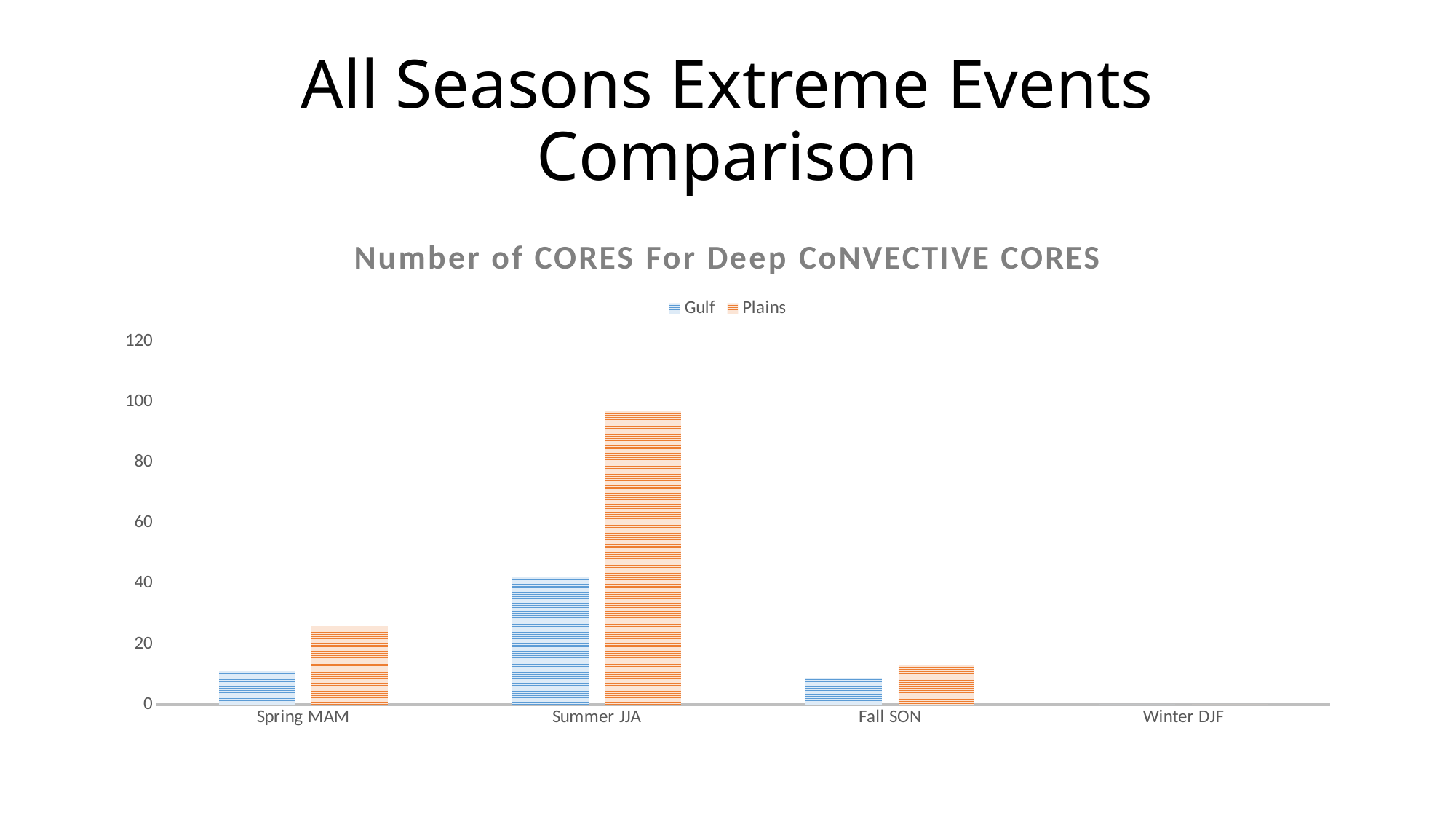
How many seasons are shown on the x axis? 4 Which two series are listed in the legend? Gulf and Plains How many series does the legend list? 2 In which season is the Plains value highest? Summer JJA Which season shows no bars for either series? Winter DJF What kind of chart is shown on the slide? Bar chart Is the Plains value for Summer JJA greater or less than 80? greater In which season is the Gulf value highest? Summer JJA In Spring MAM, which series has the larger value, Gulf or Plains? Plains What is the title of the chart? Number of CORES For Deep CoNVECTIVE CORES Is the Gulf value for Spring MAM greater or less than 20? less In Summer JJA, which series has the larger value, Gulf or Plains? Plains